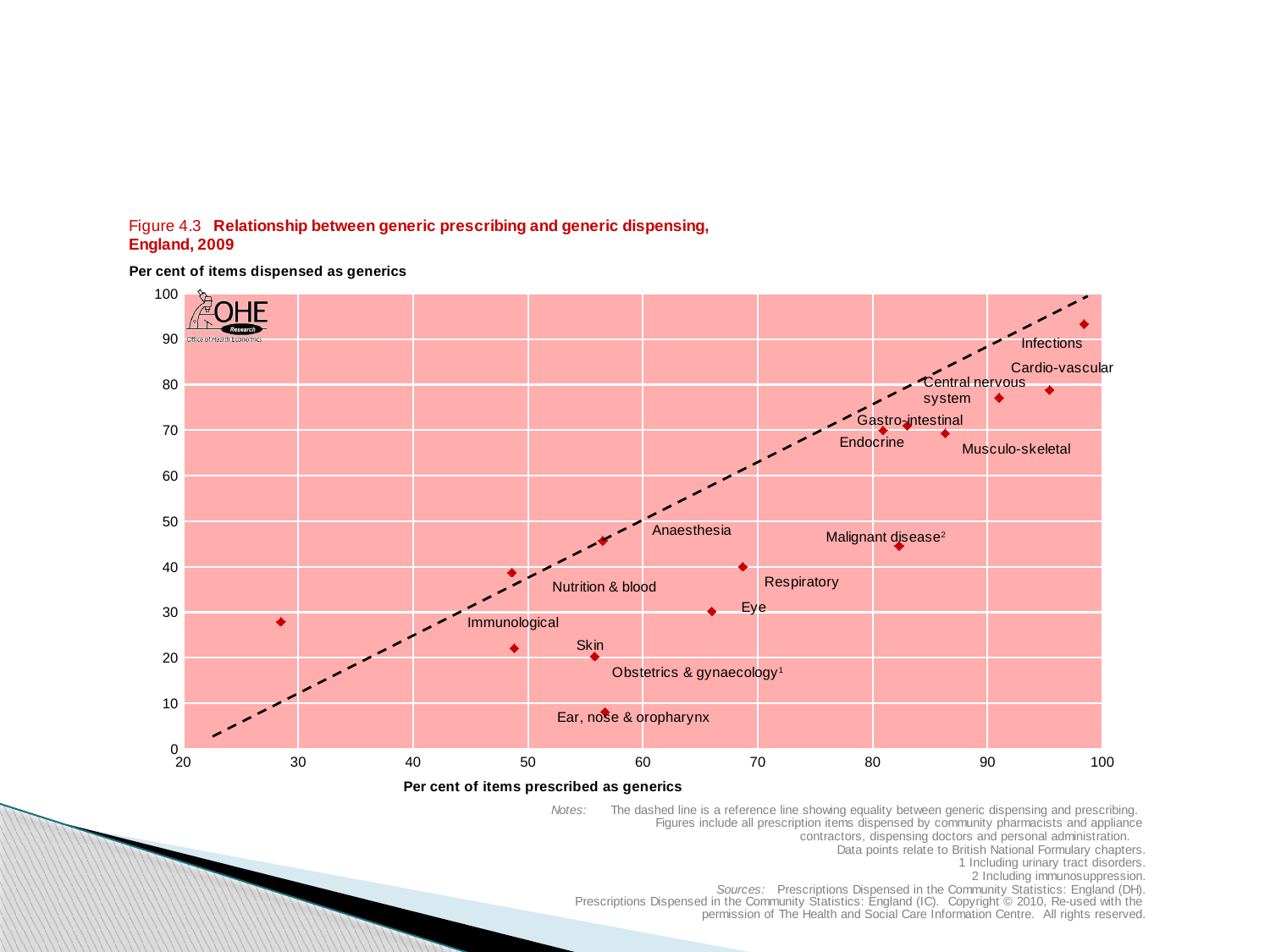
Which has a higher per cent of items dispensed as generics, Infections or Cardio-vascular? Infections Which category has the lowest per cent of items dispensed as generics? Ear, nose & oropharynx Is the per cent of items dispensed as generics for Malignant disease greater or less than 50? less Is the per cent of items dispensed as generics for Ear, nose & oropharynx greater or less than 10? less Which has a higher per cent of items dispensed as generics, Anaesthesia or Eye? Anaesthesia What is the label of the horizontal axis? Per cent of items prescribed as generics Is the per cent of items prescribed as generics for Cardio-vascular greater or less than 90? greater What kind of chart is shown on the slide? Scatter chart Which category has the highest per cent of items dispensed as generics? Infections According to the notes, what does the dashed line represent? A reference line showing equality between generic dispensing and prescribing